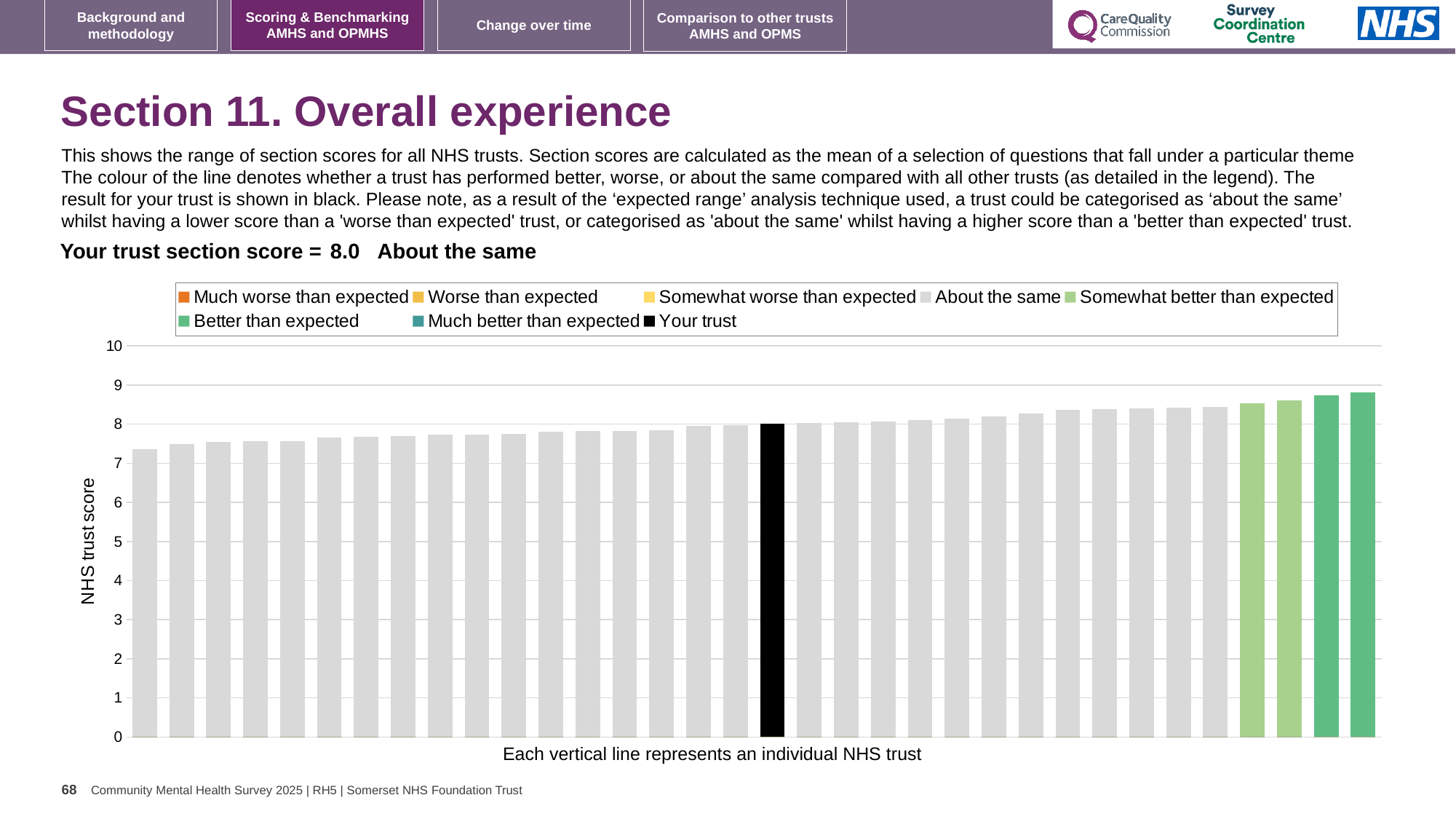
Which is higher, the black 'Your trust' bar or the leftmost bar? The black 'Your trust' bar Is the value of the rightmost bar greater or less than 8? greater What is the section score for your trust shown on the slide? 8.0 Do the bar values rise or fall from left to right along the x axis? Rise How many entries does the chart legend list? 8 What is the label on the y axis of the chart? NHS trust score Is the value of the black 'Your trust' bar greater or less than 7? greater How many bars are coloured as 'Better than expected' (darker green)? 2 What type of chart is shown on the slide? Bar chart Is the value of the leftmost bar greater or less than 8? less How many bars are coloured as 'Somewhat better than expected' (light green)? 2 What category is your trust's section score placed in, according to the text above the chart? About the same